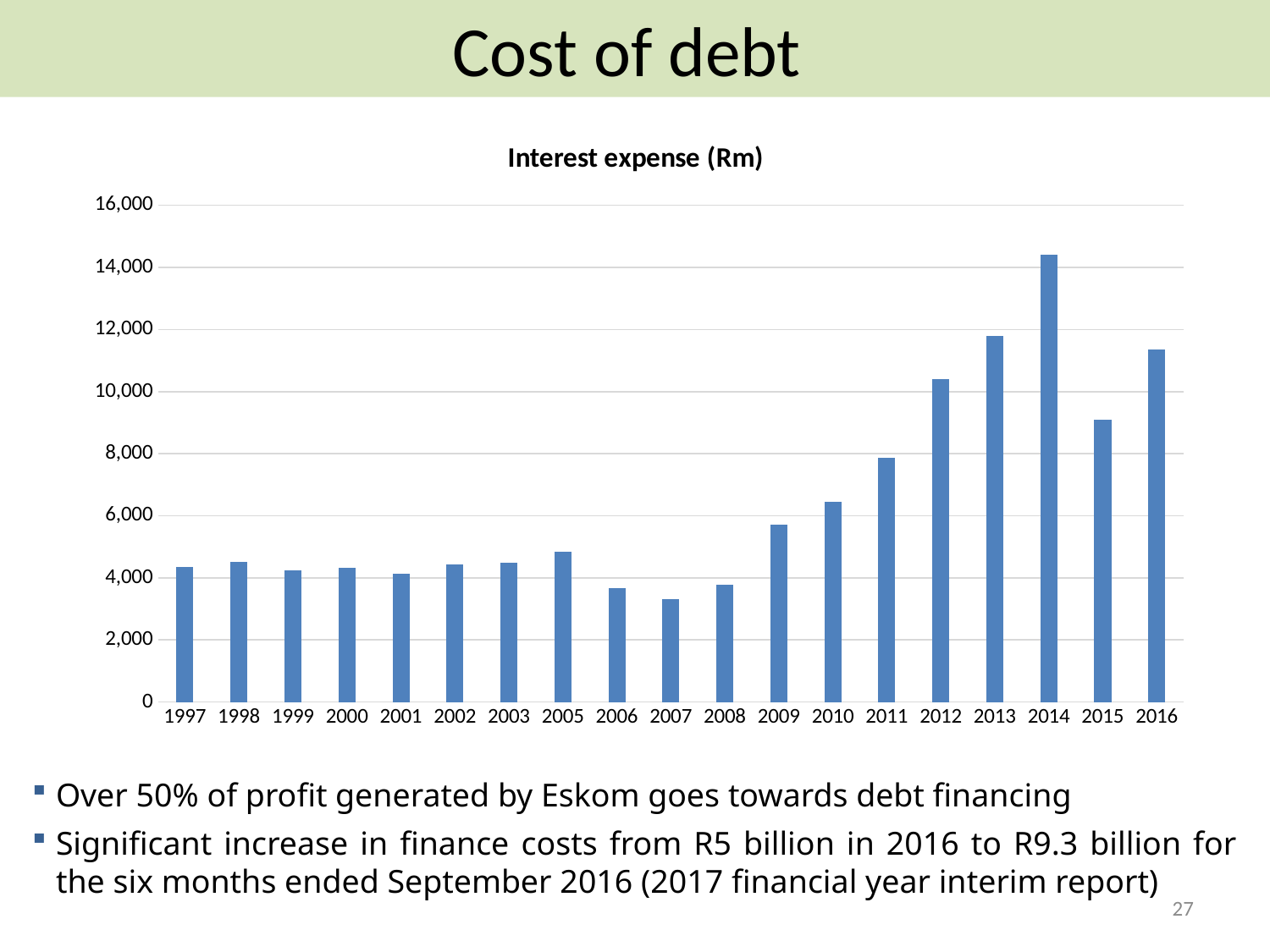
Which year has the lowest interest expense? 2007 Which year has the highest interest expense? 2014 Is the interest expense for 2014 greater or less than 14,000? greater Is the interest expense for 2016 greater or less than 10,000? greater What kind of chart is shown on the slide? bar chart Is the interest expense for 2007 greater or less than 4,000? less Which year has the larger interest expense, 2009 or 2010? 2010 How many years are shown on the x axis of the chart? 19 What is the title of the chart? Interest expense (Rm) Which year has the larger interest expense, 2013 or 2015? 2013 Does the interest expense rise or fall from 2008 to 2014? rise